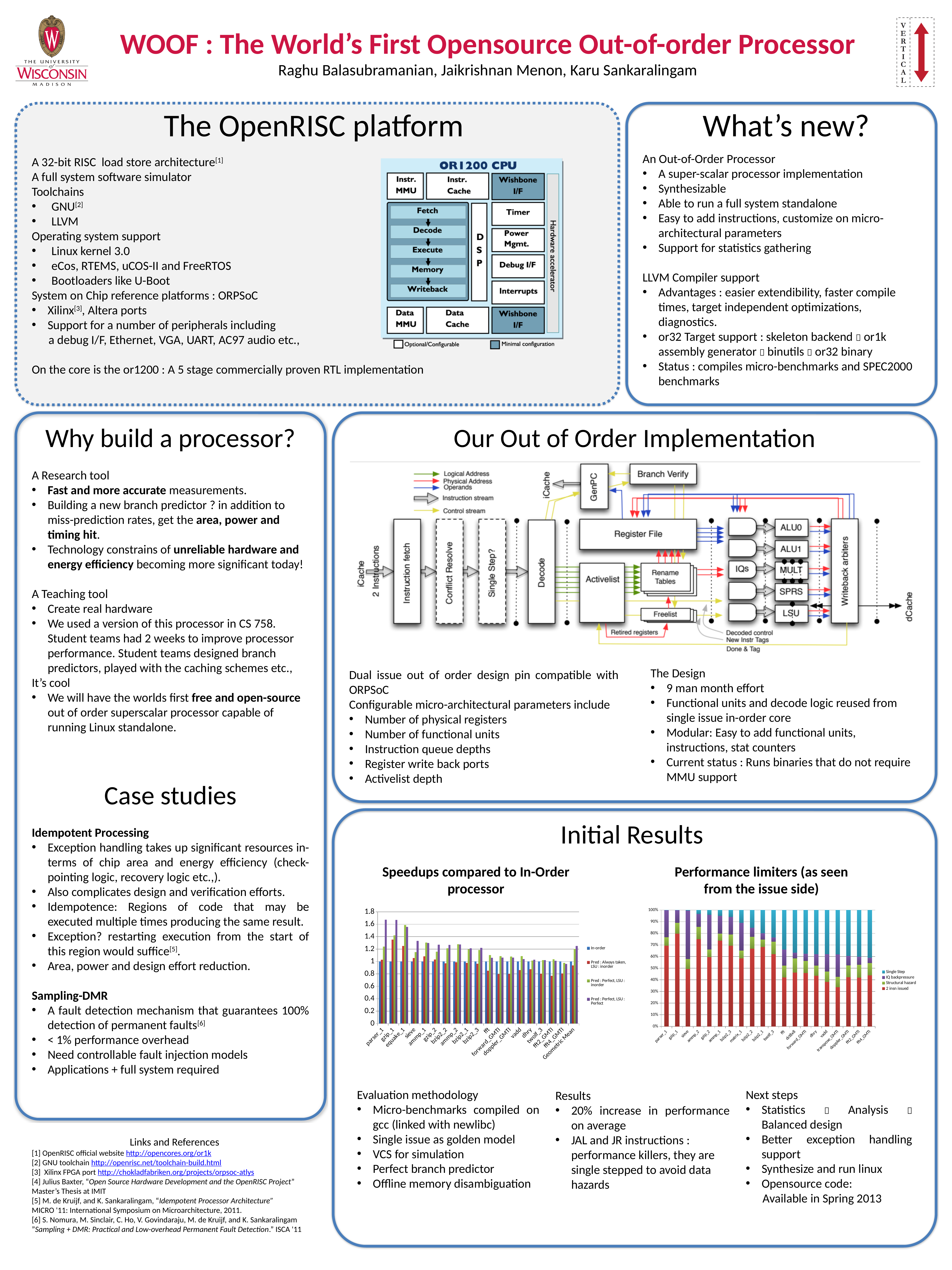
In the 'Performance limiters (as seen from the issue side)' chart, what is the total height of each stacked bar? 100% In the 'Speedups compared to In-Order processor' chart, is the 'Pred : Perfect, LSU : Perfect' value for Geometric Mean greater or less than 1.2? greater Which legend entry in the 'Performance limiters (as seen from the issue side)' chart is shown in red? 2 insn issued How many series does the legend of the 'Performance limiters (as seen from the issue side)' chart list? 4 How many series does the legend of the 'Speedups compared to In-Order processor' chart list? 4 In the 'Speedups compared to In-Order processor' chart, is the 'Pred : Perfect, LSU : Perfect' value for gzip_1 greater or less than 1.6? greater What kind of chart is the 'Performance limiters (as seen from the issue side)' chart? stacked bar chart What kind of chart is the 'Speedups compared to In-Order processor' chart? bar chart In the 'Speedups compared to In-Order processor' chart, how many categories are shown on the x axis? 19 In the 'Speedups compared to In-Order processor' chart, is the 'Pred : Perfect, LSU : Perfect' value for vadd greater or less than 1.4? less In the 'Speedups compared to In-Order processor' chart, what is the value of the In-order series for parser_1? 1